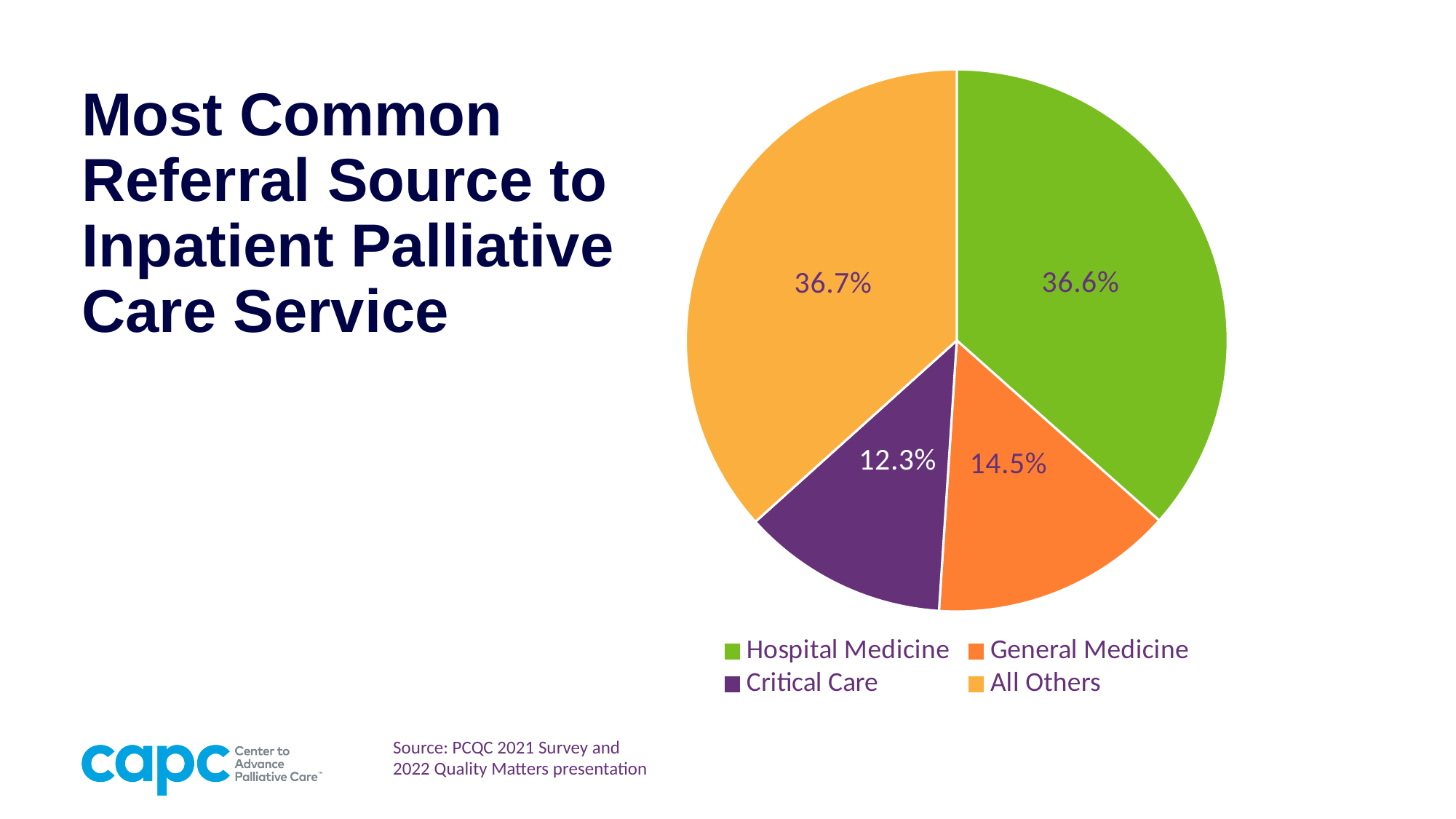
What share of the pie does Hospital Medicine account for? 36.6% Which is larger, the slice for Hospital Medicine or the slice for General Medicine? Hospital Medicine Which is larger, the slice for General Medicine or the slice for Critical Care? General Medicine What percentage is shown for Critical Care? 12.3% Which colour represents Hospital Medicine in the pie chart? Green How many slices does the pie chart have? 4 What is the difference in percentage points between Hospital Medicine and General Medicine? 22.1 percentage points What kind of chart is shown on the slide? Pie chart What share of the pie is labelled All Others? 36.7% What is the difference in percentage points between General Medicine and Critical Care? 2.2 percentage points What percentage is shown for General Medicine? 14.5% Which referral source has the smallest slice of the pie? Critical Care